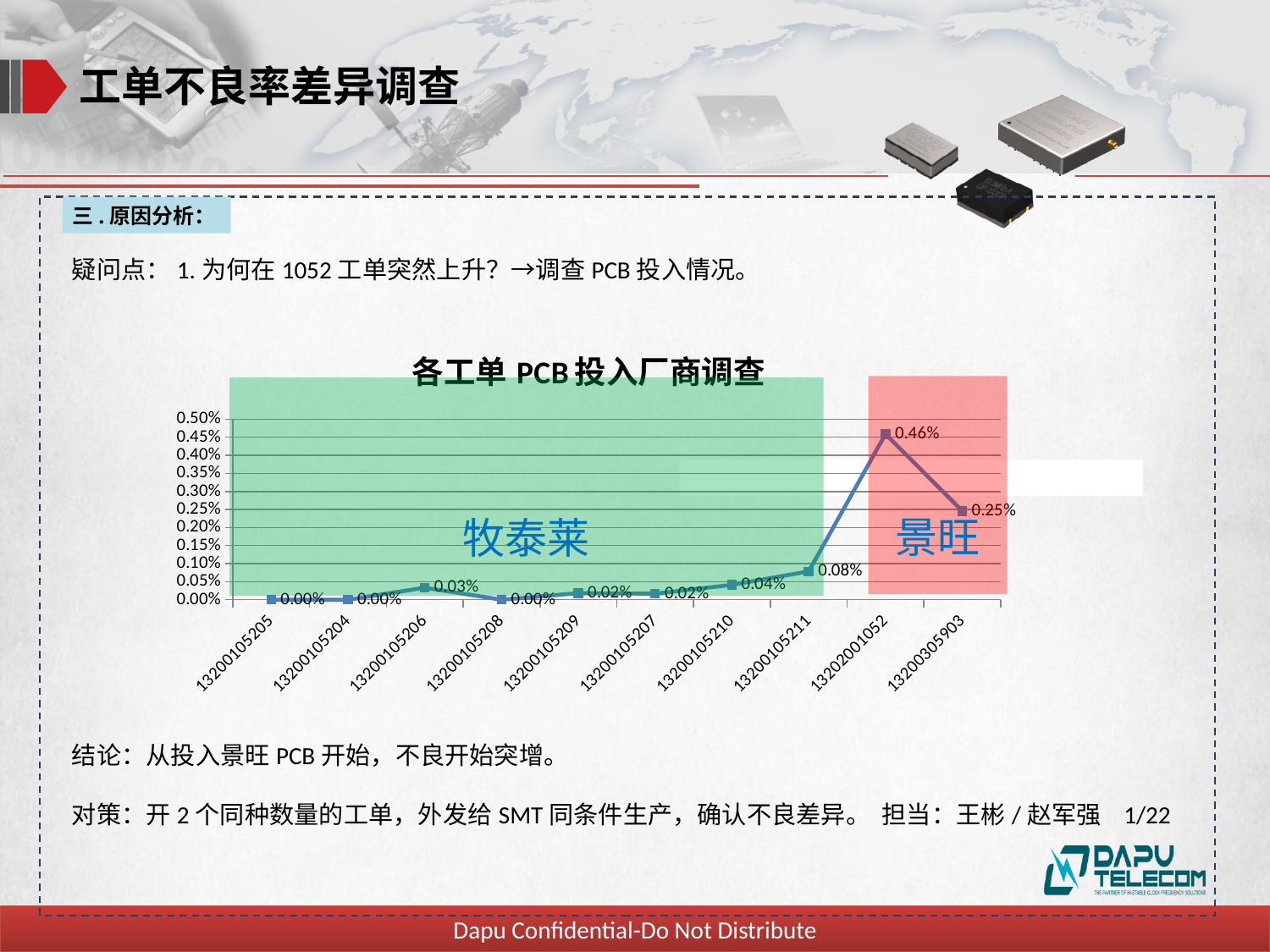
What is the value for work order 13200305903? 0.25% How many work orders are plotted on the x axis? 10 Is the value for 13202001052 greater or less than 0.40%? greater What is the value for work order 13202001052? 0.46% What is the difference between the values for 13202001052 and 13200305903? 0.21% Which supplier name is shown in the red shaded region of the chart? 景旺 What is the title of the chart? 各工单 PCB 投入厂商调查 What kind of chart is shown? line chart Which work order has the highest value? 13202001052 What is the value for work order 13200105211? 0.08% What is the value for work order 13200105206? 0.03% Which is larger, the value for 13200105211 or the value for 13200105210? 13200105211